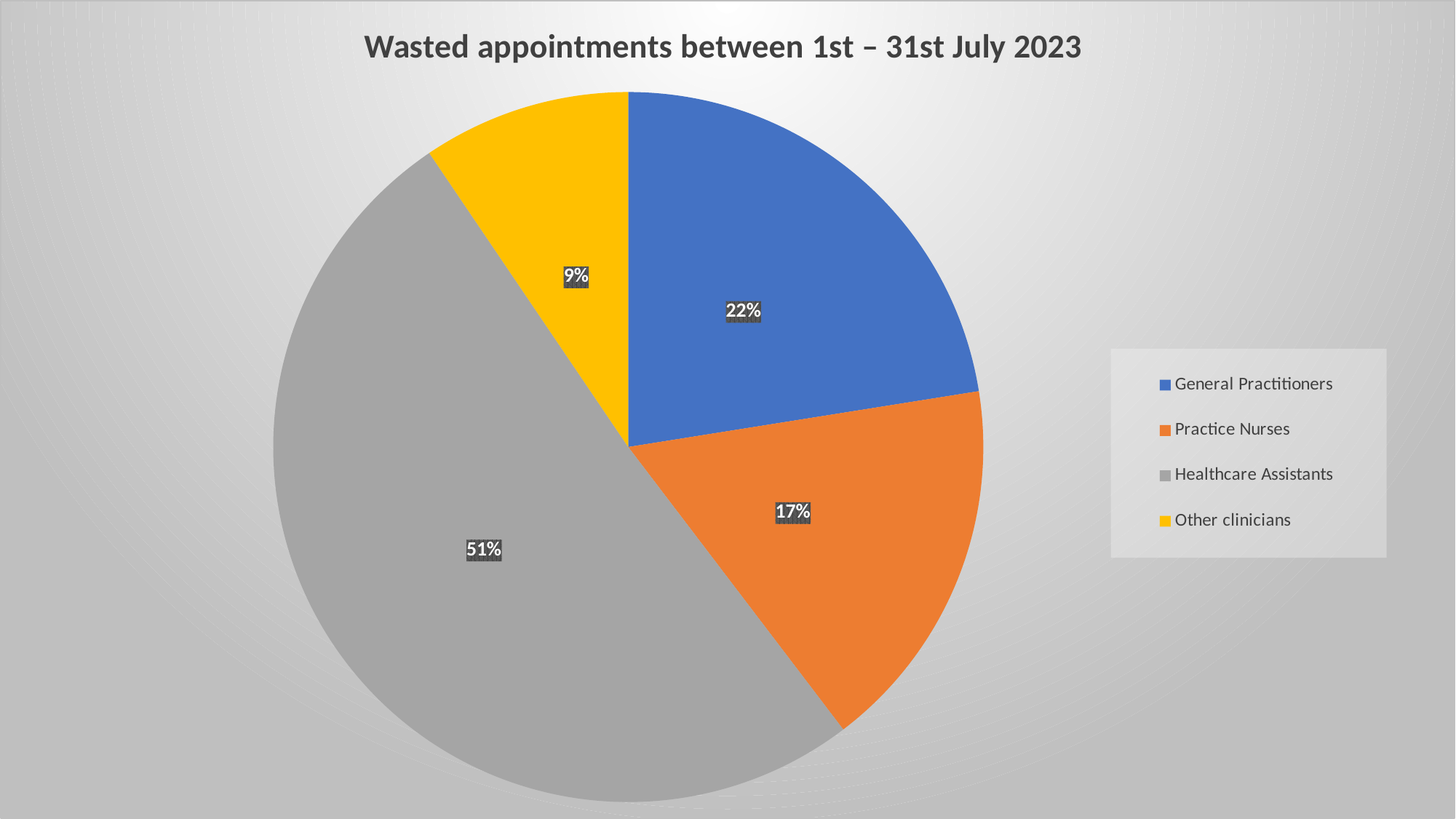
Which category accounts for the largest share of wasted appointments? Healthcare Assistants What share of wasted appointments is attributed to Other clinicians? 9% What is the title of the chart? Wasted appointments between 1st – 31st July 2023 What share of wasted appointments is attributed to Healthcare Assistants? 51% What share of wasted appointments is attributed to Practice Nurses? 17% Which has a larger share of wasted appointments, Practice Nurses or Other clinicians? Practice Nurses How many categories are shown in the pie chart? 4 What type of chart is shown on the slide? Pie chart Which category accounts for the smallest share of wasted appointments? Other clinicians What is the difference in percentage points between the General Practitioners share and the Practice Nurses share? 5 What is the difference in percentage points between the Healthcare Assistants share and the General Practitioners share? 29